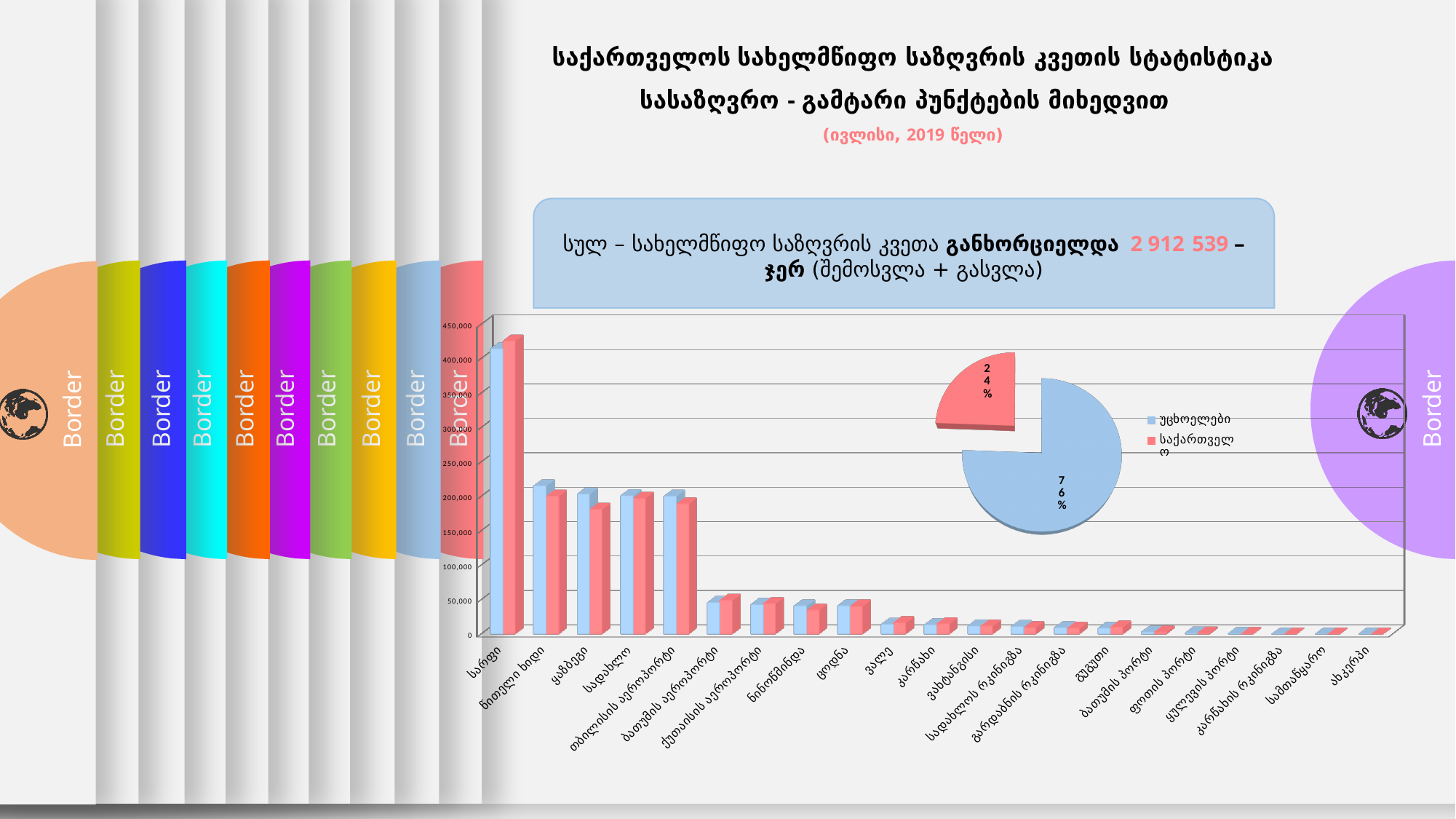
In the pie chart, what is the difference in percentage points between the უცხოელები slice and the საქართველო slice? 52% What kind of chart is the chart on the left side of the slide (with the 450,000 axis)? bar chart What kind of chart is the chart on the right side of the slide? pie chart In the bar chart, is the blue bar for სარფი greater or less than 400,000? greater In the bar chart, do the values generally rise or fall moving from left to right along the x axis? fall In the pie chart, what share does the საქართველო slice have? 24% In the bar chart, is the red bar for ყაზბეგი greater or less than 200,000? less In the pie chart, which slice is larger, უცხოელები or საქართველო? უცხოელები How many entries does the legend of the pie chart list? 2 In the bar chart, is the blue bar for ნინოწმინდა greater or less than 50,000? less In the pie chart, what share does the უცხოელები slice have? 76% In the bar chart, which category has the highest bars? სარფი